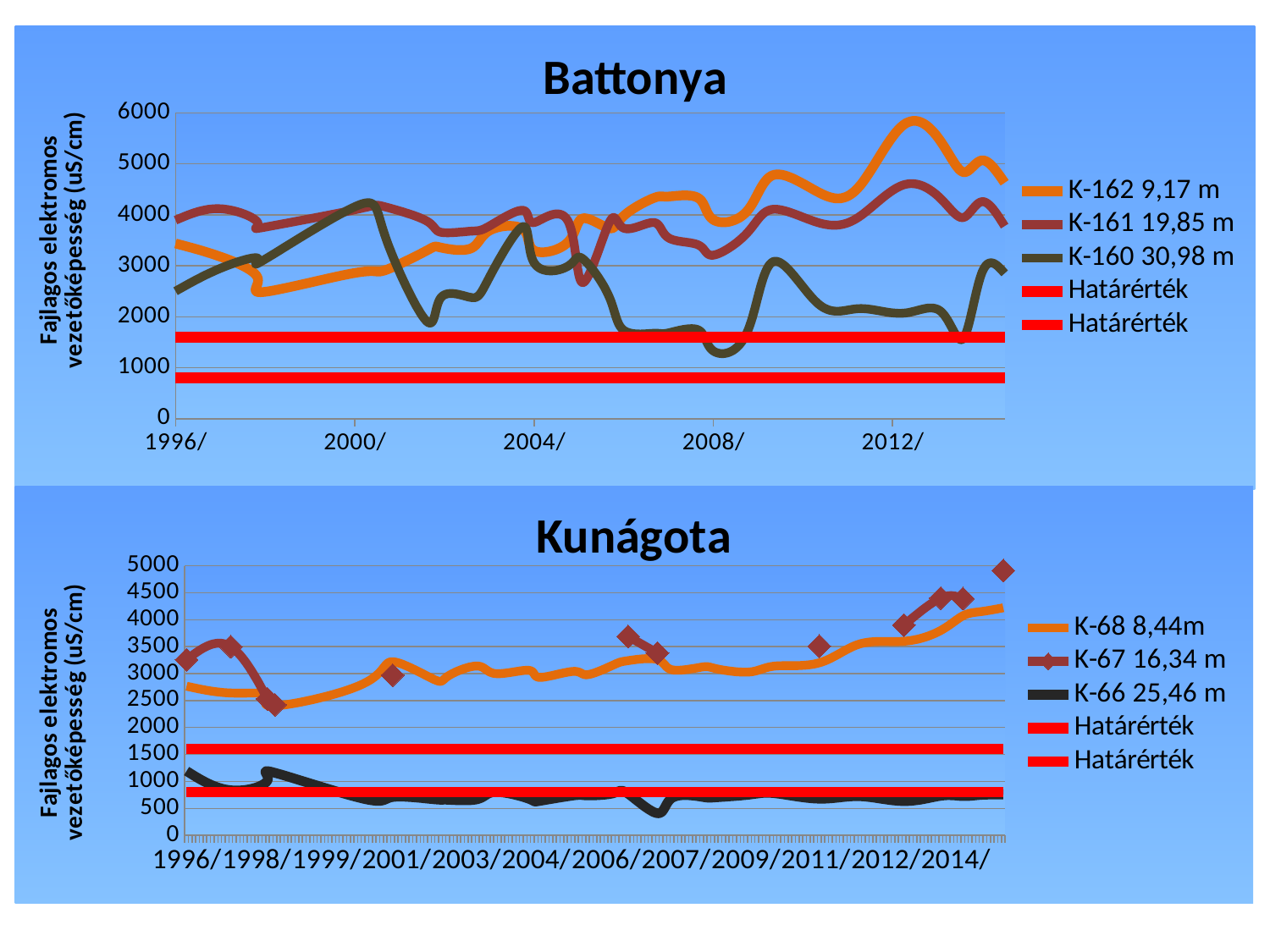
In the Kunágota chart, does the K-68 8,44m series overall rise or fall from 1996/ to 2014/? rise In the Kunágota chart, which of the well series stays lowest throughout the period? K-66 25,46 m In the Battonya chart, is the value for K-160 30,98 m at 2008/ greater or less than 2000? less How many series does the legend of the Kunágota chart list? 5 In the Battonya chart, at 1996/, which is larger: K-161 19,85 m or K-162 9,17 m? K-161 19,85 m In the Kunágota chart, is the last plotted value for K-67 16,34 m greater or less than 4500? greater How many series does the legend of the Battonya chart list? 5 In the Battonya chart, is the peak value of K-162 9,17 m greater or less than 5000? greater What kind of chart is the Battonya chart? line chart In the Battonya chart, which series reaches the highest value? K-162 9,17 m What is the y-axis label of the Kunágota chart? Fajlagos elektromos vezetőképesség (uS/cm)